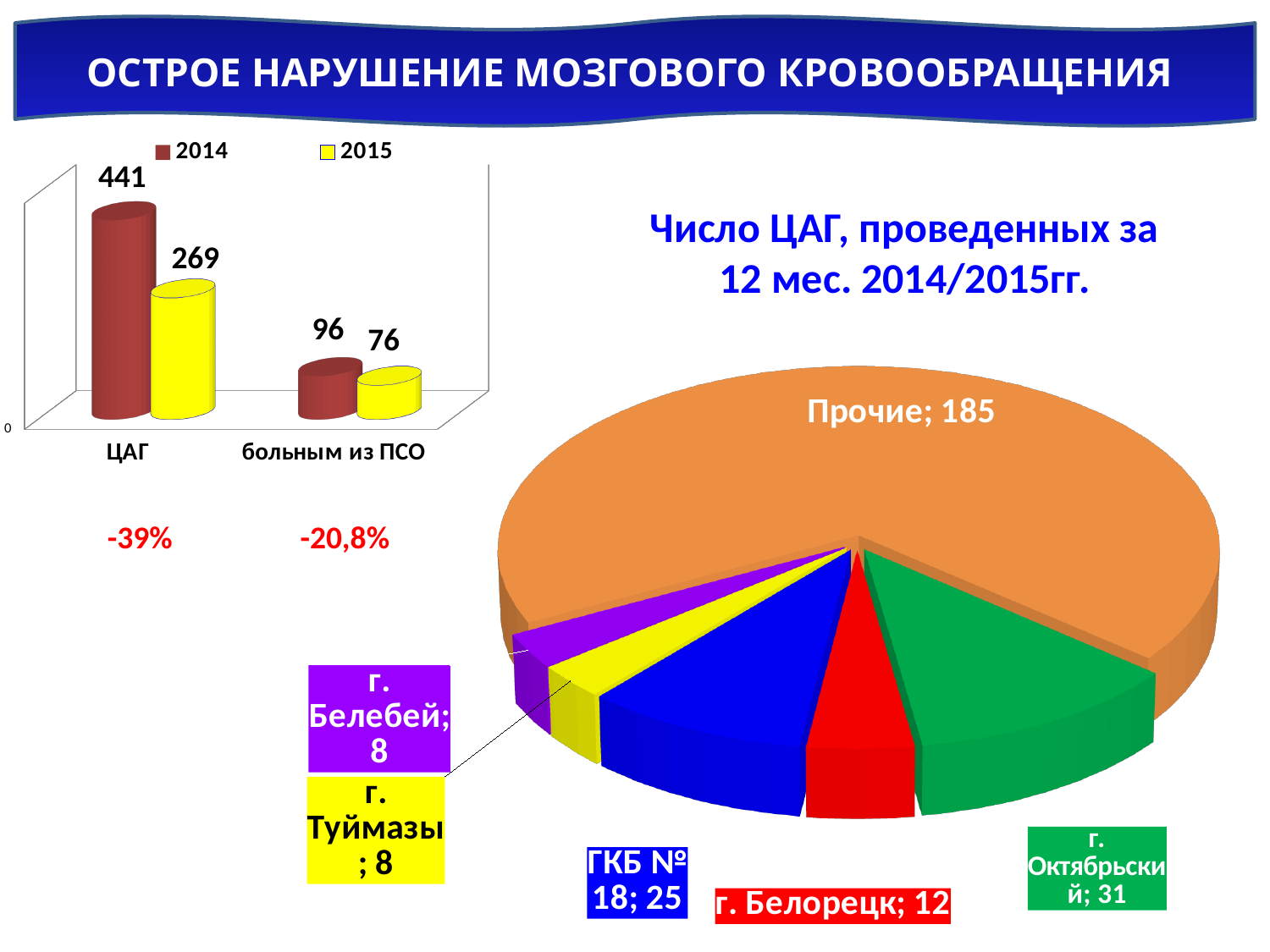
In the bar chart on the left, what is the difference between the 2014 and 2015 values for ЦАГ? 172 In the bar chart on the left, what is the 2015 value for больным из ПСО? 76 In the pie chart 'Число ЦАГ, проведенных за 12 мес. 2014/2015гг.', which slice is the largest? Прочие In the pie chart 'Число ЦАГ, проведенных за 12 мес. 2014/2015гг.', what colour is the slice for г. Белебей? Purple In the pie chart 'Число ЦАГ, проведенных за 12 мес. 2014/2015гг.', what is the value for г. Октябрьский? 31 In the pie chart 'Число ЦАГ, проведенных за 12 мес. 2014/2015гг.', how many slices are there? 6 In the pie chart 'Число ЦАГ, проведенных за 12 мес. 2014/2015гг.', what is the difference between the values for ГКБ №18 and г. Белорецк? 13 What kind of chart is the chart on the left of the slide? Bar chart In the bar chart on the left, what is the 2014 value for ЦАГ? 441 In the bar chart on the left, which is larger for больным из ПСО: the 2014 value or the 2015 value? 2014 In the bar chart on the left, how many categories are shown on the x axis? 2 In the bar chart on the left, how many series does the legend list? 2